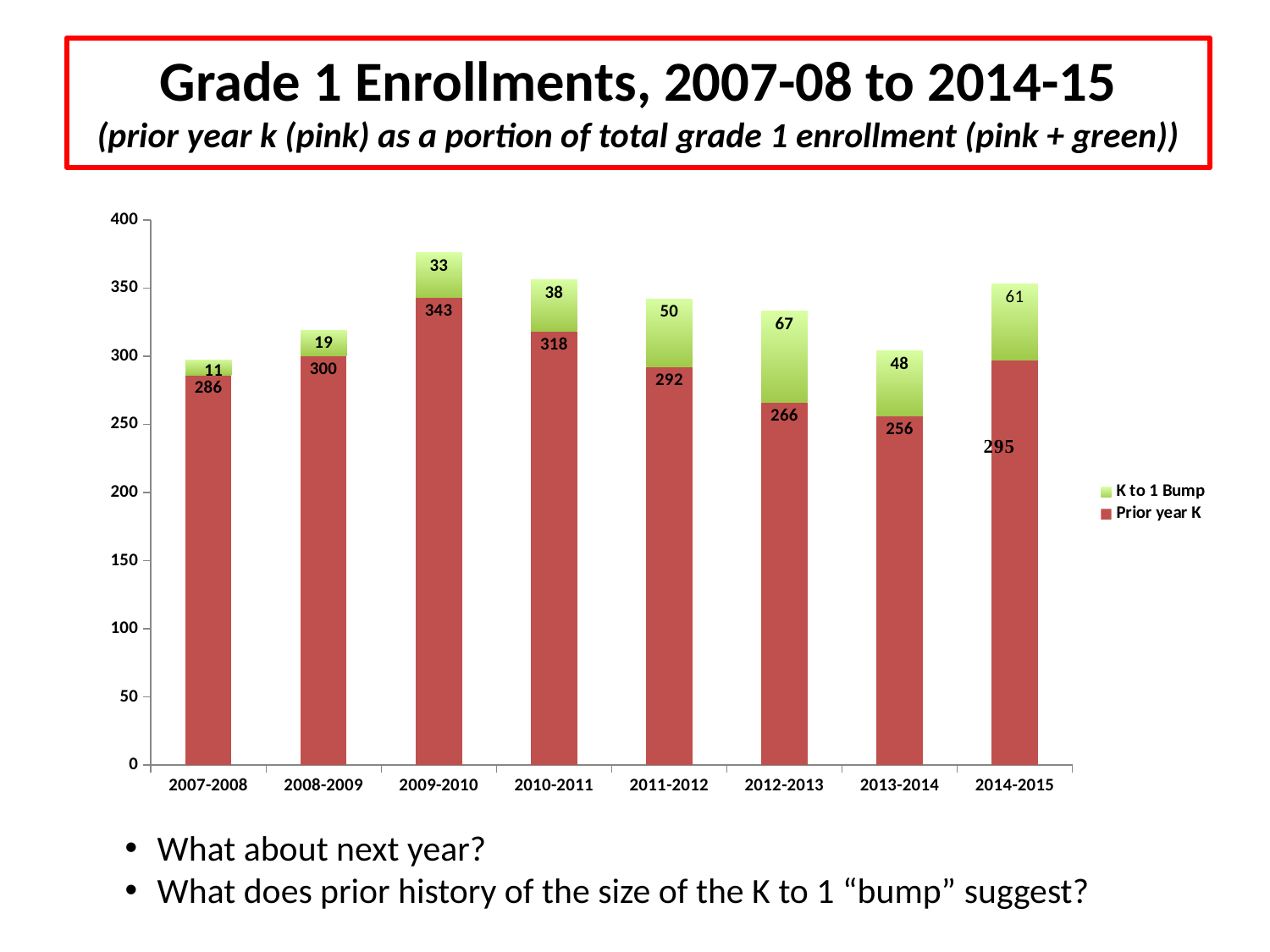
What is the total grade 1 enrollment (Prior year K plus K to 1 Bump) for 2012-2013? 333 Which is larger, the K to 1 Bump for 2011-2012 or for 2013-2014? 2011-2012 What kind of chart is shown on the slide? Stacked bar chart What is the difference between the Prior year K values for 2009-2010 and 2013-2014? 87 Which school year has the lowest K to 1 Bump value? 2007-2008 Which school year has the lowest Prior year K value? 2013-2014 What is the K to 1 Bump value for 2012-2013? 67 What is the Prior year K value for 2009-2010? 343 How many series does the legend list? 2 What is the Prior year K value for 2014-2015? 295 How many school years are shown on the x axis? 8 Which school year has the highest Prior year K value? 2009-2010